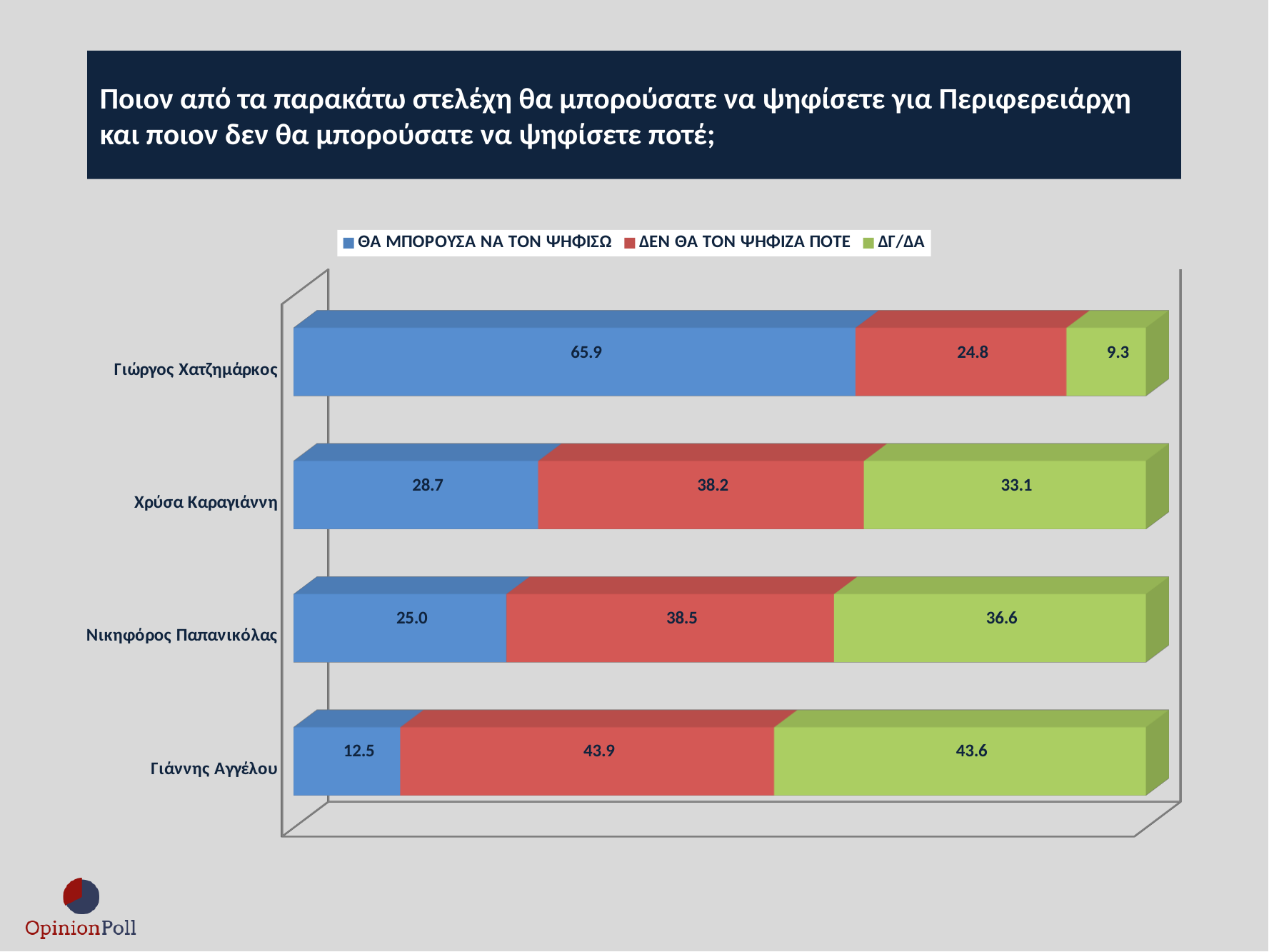
Which colour represents the ΔΓ/ΔΑ series in the chart? green What is the value of ΔΕΝ ΘΑ ΤΟΝ ΨΗΦΙΖΑ ΠΟΤΕ for Γιάννης Αγγέλου? 43.9 What is the ΔΓ/ΔΑ value for Νικηφόρος Παπανικόλας? 36.6 How many candidates (categories) are shown in the chart? 4 Which candidate has the highest ΘΑ ΜΠΟΡΟΥΣΑ ΝΑ ΤΟΝ ΨΗΦΙΣΩ value? Γιώργος Χατζημάρκος How many series does the legend list? 3 Which candidate has the lowest ΔΓ/ΔΑ value? Γιώργος Χατζημάρκος What is the total of the stacked bar for Χρύσα Καραγιάννη? 100.0 What kind of chart is shown on the slide? bar chart What is the value of ΘΑ ΜΠΟΡΟΥΣΑ ΝΑ ΤΟΝ ΨΗΦΙΣΩ for Γιώργος Χατζημάρκος? 65.9 Which is larger: the ΔΕΝ ΘΑ ΤΟΝ ΨΗΦΙΖΑ ΠΟΤΕ value for Χρύσα Καραγιάννη or for Γιάννης Αγγέλου? Γιάννης Αγγέλου What is the difference between the ΘΑ ΜΠΟΡΟΥΣΑ ΝΑ ΤΟΝ ΨΗΦΙΣΩ values of Γιώργος Χατζημάρκος and Χρύσα Καραγιάννη? 37.2